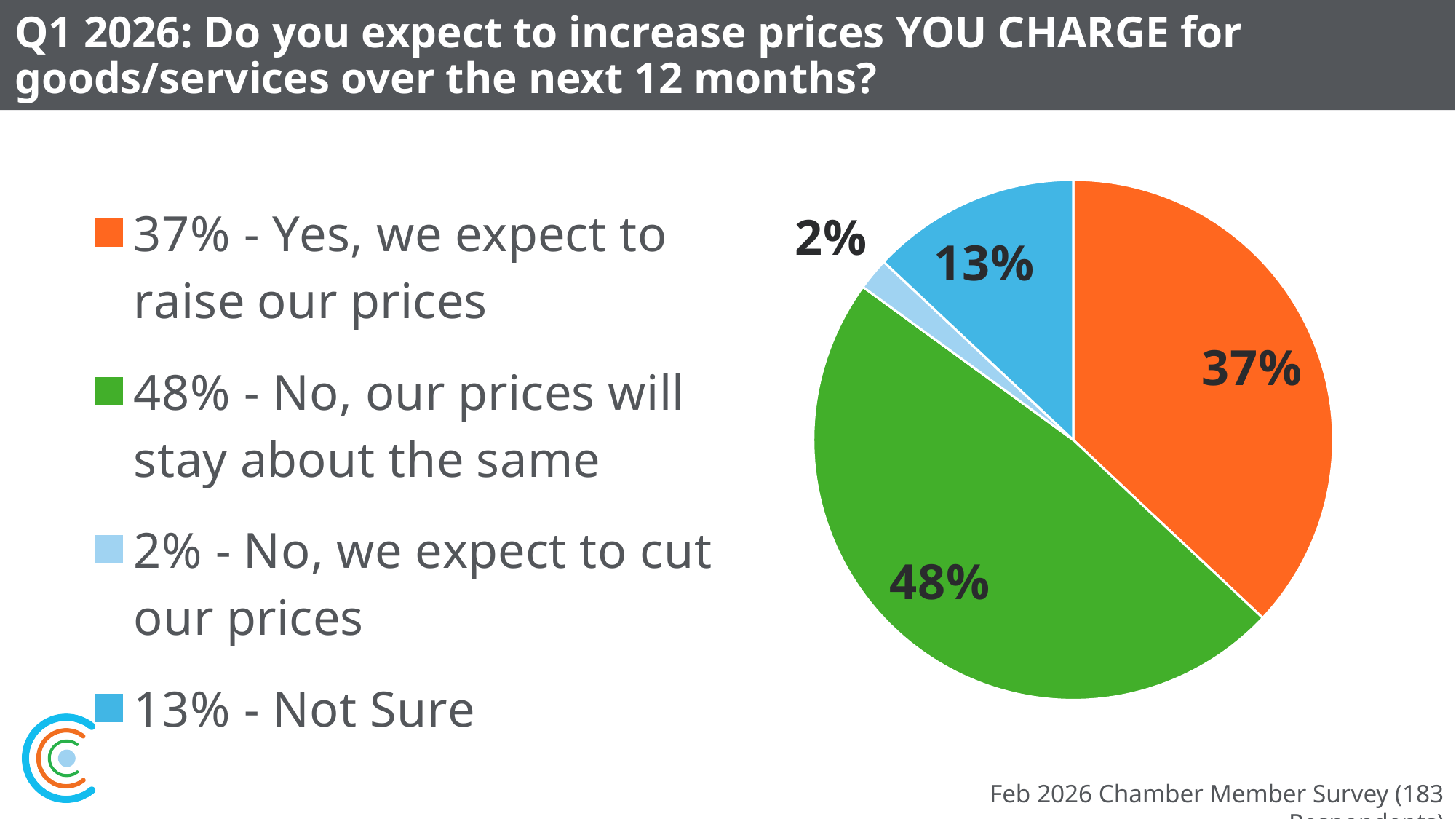
Which response has the smallest share of the pie? No, we expect to cut our prices Which is larger: the share expecting to raise prices or the share that is Not Sure? The share expecting to raise prices What share of respondents answered Not Sure? 13% What share of respondents said they expect to cut their prices? 2% What share of respondents said their prices will stay about the same? 48% What colour is the slice for 'Not Sure'? Blue What is the difference in percentage points between the 'stay about the same' share and the 'raise our prices' share? 11 percentage points Which response has the largest share of the pie? No, our prices will stay about the same What kind of chart is shown on the slide? Pie chart What is the combined share of respondents who do not expect to raise prices (stay the same plus cut)? 50% How many slices does the pie chart have? 4 What share of respondents said they expect to raise their prices? 37%